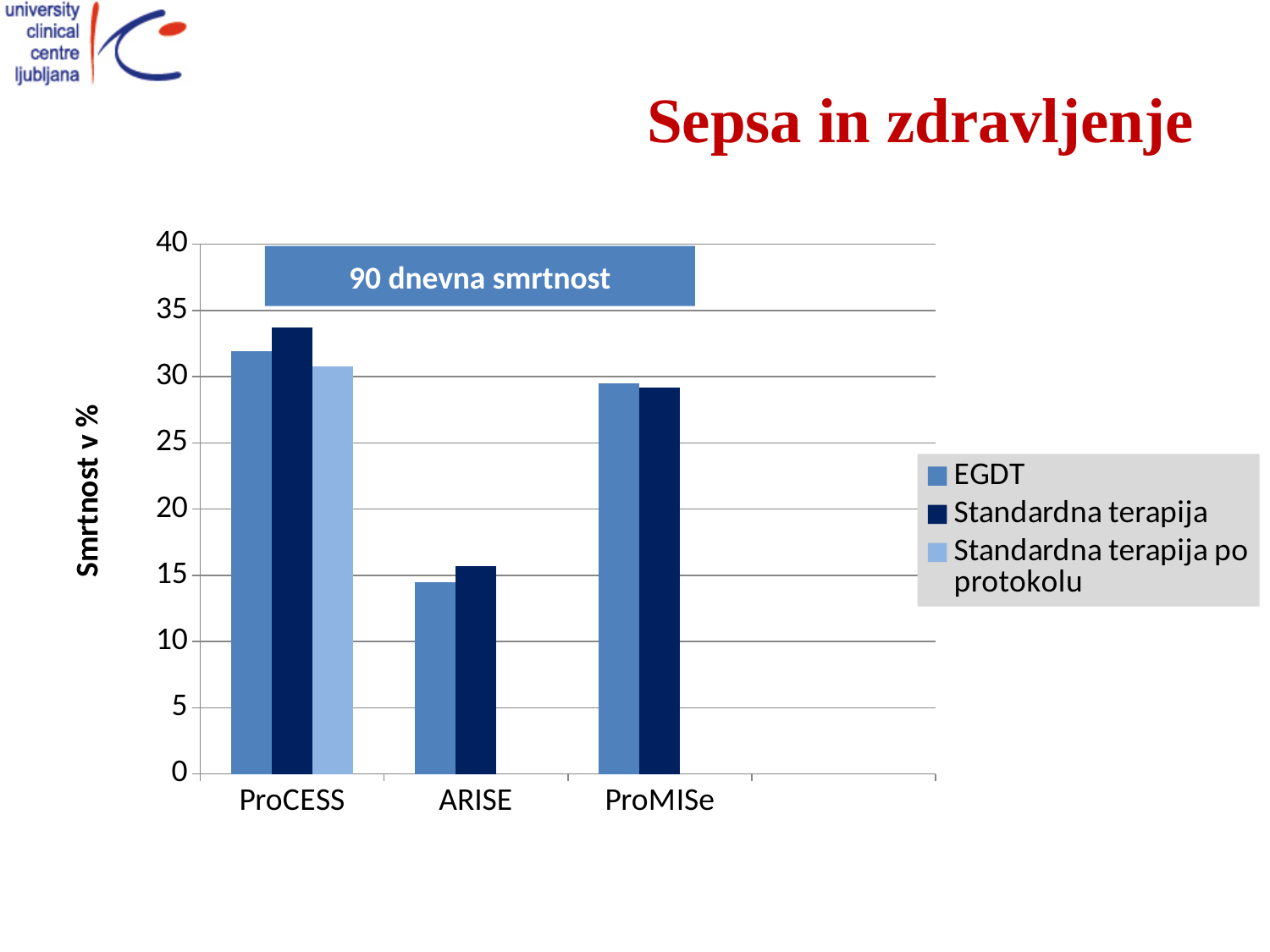
What kind of chart is shown on the slide? bar chart What is the title of the y axis? Smrtnost v % Which category has the highest Standardna terapija value? ProCESS For ProCESS, which is larger: Standardna terapija or Standardna terapija po protokolu? Standardna terapija Which category has the lowest EGDT value? ARISE Is the EGDT value for ARISE greater or less than 20? less How many series does the legend list? 3 Which has the larger EGDT value, ProCESS or ARISE? ProCESS Is the EGDT value for ProCESS greater or less than 30? greater Is the EGDT value for ProMISe greater or less than 25? greater How many trial categories are shown on the x axis? 3